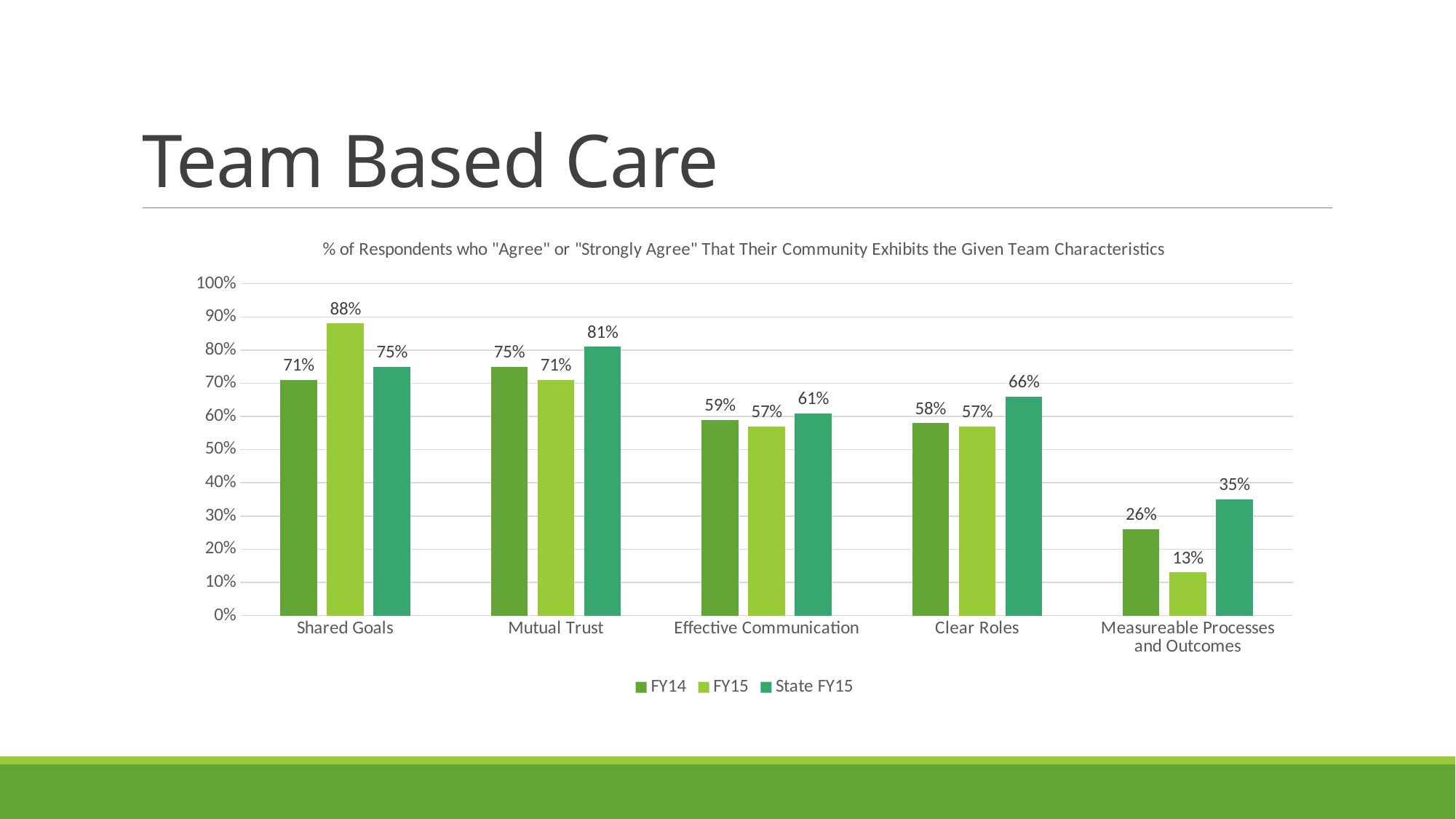
What is the FY15 value for Shared Goals? 88% What is the difference between the FY15 and FY14 values for Shared Goals? 17% How many series does the legend list? 3 What is the FY14 value for Measureable Processes and Outcomes? 26% Which is larger for Clear Roles, the FY14 value or the State FY15 value? State FY15 Which category has the lowest FY15 value? Measureable Processes and Outcomes What are the three series listed in the legend? FY14, FY15, State FY15 What is the difference between the State FY15 and FY15 values for Measureable Processes and Outcomes? 22% What is the State FY15 value for Mutual Trust? 81% Which category has the highest State FY15 value? Mutual Trust What kind of chart is shown on the slide? Bar chart How many categories are shown on the x axis? 5